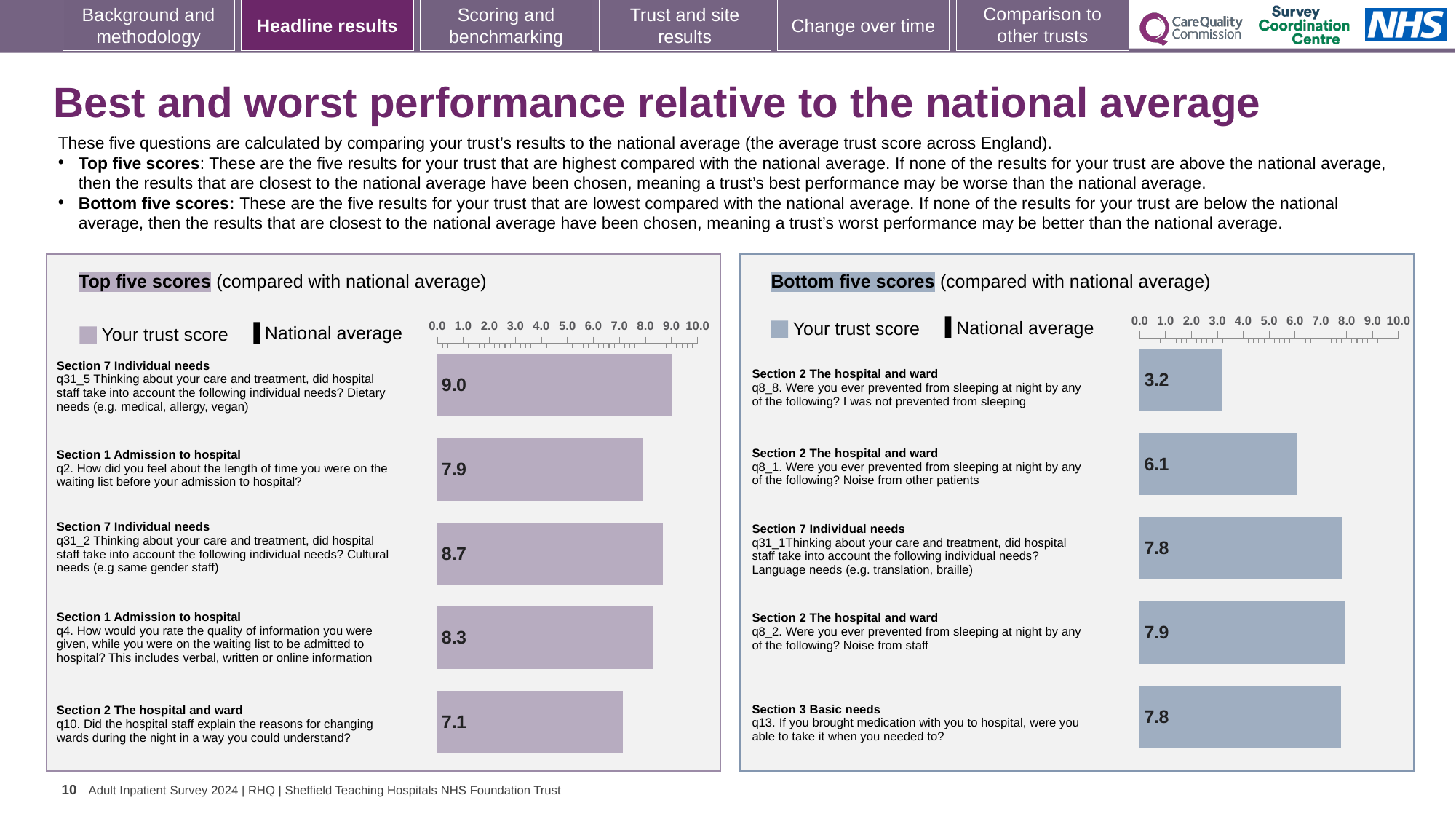
In the Top five scores chart, which question has the highest trust score? q31_5 (dietary needs) In the Bottom five scores chart, which question has the lowest trust score? q8_8 (I was not prevented from sleeping) In the Top five scores chart, what is the trust score for q31_5 (dietary needs)? 9.0 How many bars are plotted in the Bottom five scores chart? 5 In the Top five scores chart, which has the larger score: q31_2 (cultural needs) or q4 (quality of information on the waiting list)? q31_2 (cultural needs) In the Top five scores chart, what is the trust score for q2 (length of time on the waiting list)? 7.9 In the Bottom five scores chart, what is the trust score for q8_1 (noise from other patients)? 6.1 In the Top five scores chart, what is the difference between the scores for q31_5 (9.0) and q10 (7.1)? 1.9 In the Bottom five scores chart, what is the difference between the scores for q8_2 (7.9) and q8_8 (3.2)? 4.7 In the Bottom five scores chart, what is the trust score for q8_8 (I was not prevented from sleeping)? 3.2 What type of chart is used in the Top five scores panel? Bar chart In the Top five scores chart, which question has the lowest trust score? q10 (reasons for changing wards during the night)